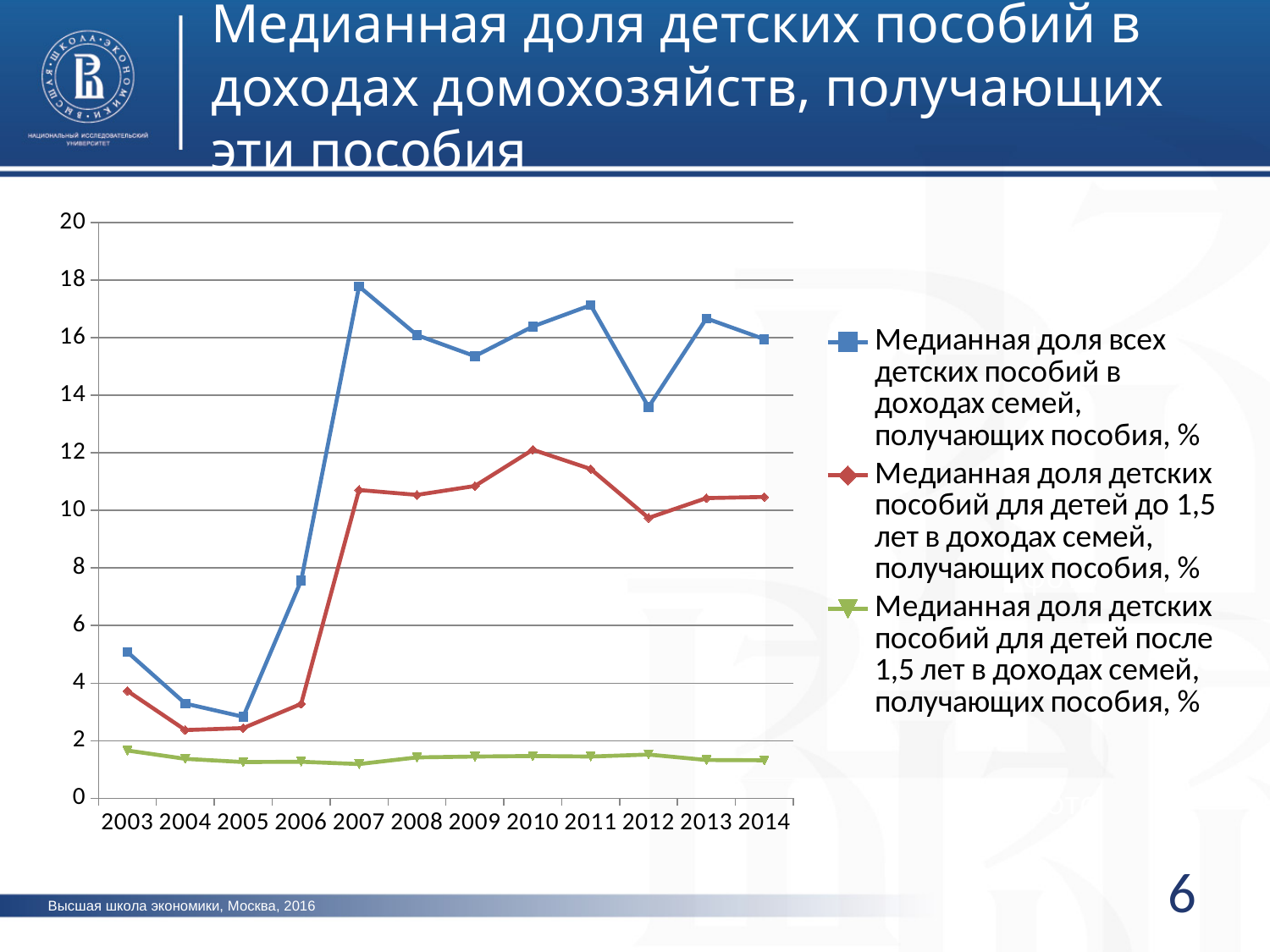
How many years are shown on the x axis? 12 In which year is the green series (benefits for children after 1.5 years) at its highest? 2003 Is the value of the green series in 2014 greater or less than 2? less In which year does the blue series (median share of all child benefits) reach its highest value? 2007 How many series does the legend list? 3 Is the value of the red series in 2010 greater or less than 10? greater Is the value of the blue series in 2007 greater or less than 16? greater Does the blue series rise or fall between 2005 and 2007? rise What kind of chart is shown on the slide? line chart In 2007, which series has the higher value: the blue series (all child benefits) or the red series (benefits for children under 1.5 years)? the blue series (all child benefits) In which year does the red series (benefits for children under 1.5 years) reach its highest value? 2010 In which year is the blue series (median share of all child benefits) at its lowest? 2005